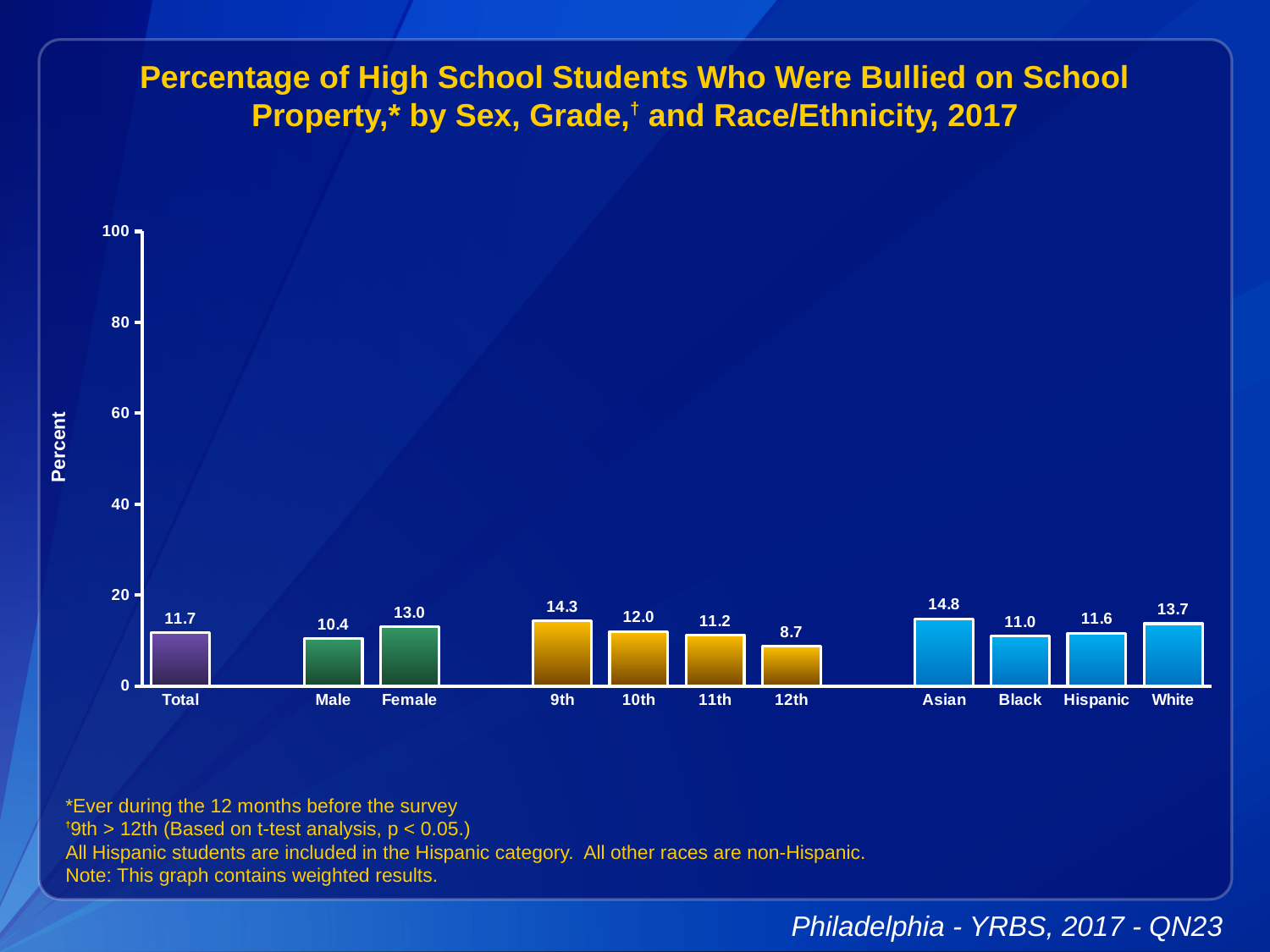
Which is larger, the value for 9th grade or 12th grade? 9th What is the label on the y axis? Percent Which category has the lowest value? 12th What is the value for Total? 11.7 What kind of chart is this? bar chart What is the value for Asian students? 14.8 Which category has the highest value? Asian What is the value for 12th grade? 8.7 What is the value for Female? 13.0 What is the difference between the Female and Male values? 2.6 How many categories are shown on the x axis? 11 Is the value for White greater or less than 20? less